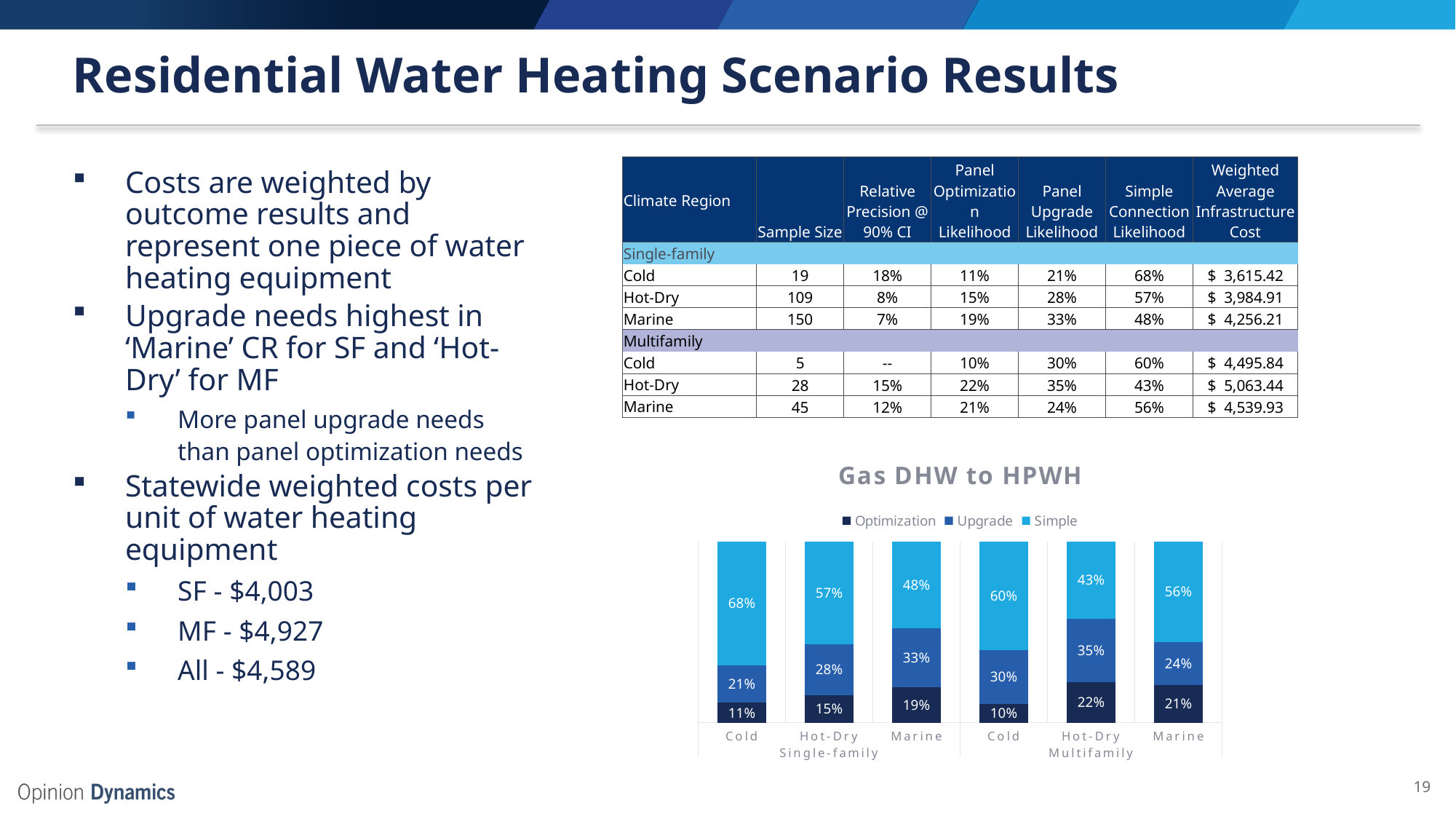
In the 'Gas DHW to HPWH' chart, what is the Upgrade value for Hot-Dry in the Multifamily group? 35% In the 'Gas DHW to HPWH' chart, is the Simple value larger for Hot-Dry Single-family or Hot-Dry Multifamily? Hot-Dry Single-family What type of chart is 'Gas DHW to HPWH'? Stacked bar chart In the 'Gas DHW to HPWH' chart, which bar has the highest Simple value? Cold (Single-family) In the 'Gas DHW to HPWH' chart, which bar has the lowest Optimization value? Cold (Multifamily) In the 'Gas DHW to HPWH' chart, what is the Simple value for Cold in the Single-family group? 68% In the 'Gas DHW to HPWH' chart, what is the difference between the Upgrade values for Marine Single-family and Marine Multifamily? 9% In the 'Gas DHW to HPWH' chart, which series is shown in the lightest blue colour? Simple How many bars are shown in the 'Gas DHW to HPWH' chart? 6 In the 'Gas DHW to HPWH' chart, what is the Optimization value for Marine in the Single-family group? 19% How many series does the legend of the 'Gas DHW to HPWH' chart list? 3 In the 'Gas DHW to HPWH' chart, what is the total of the stacked bar for Cold in the Multifamily group? 100%